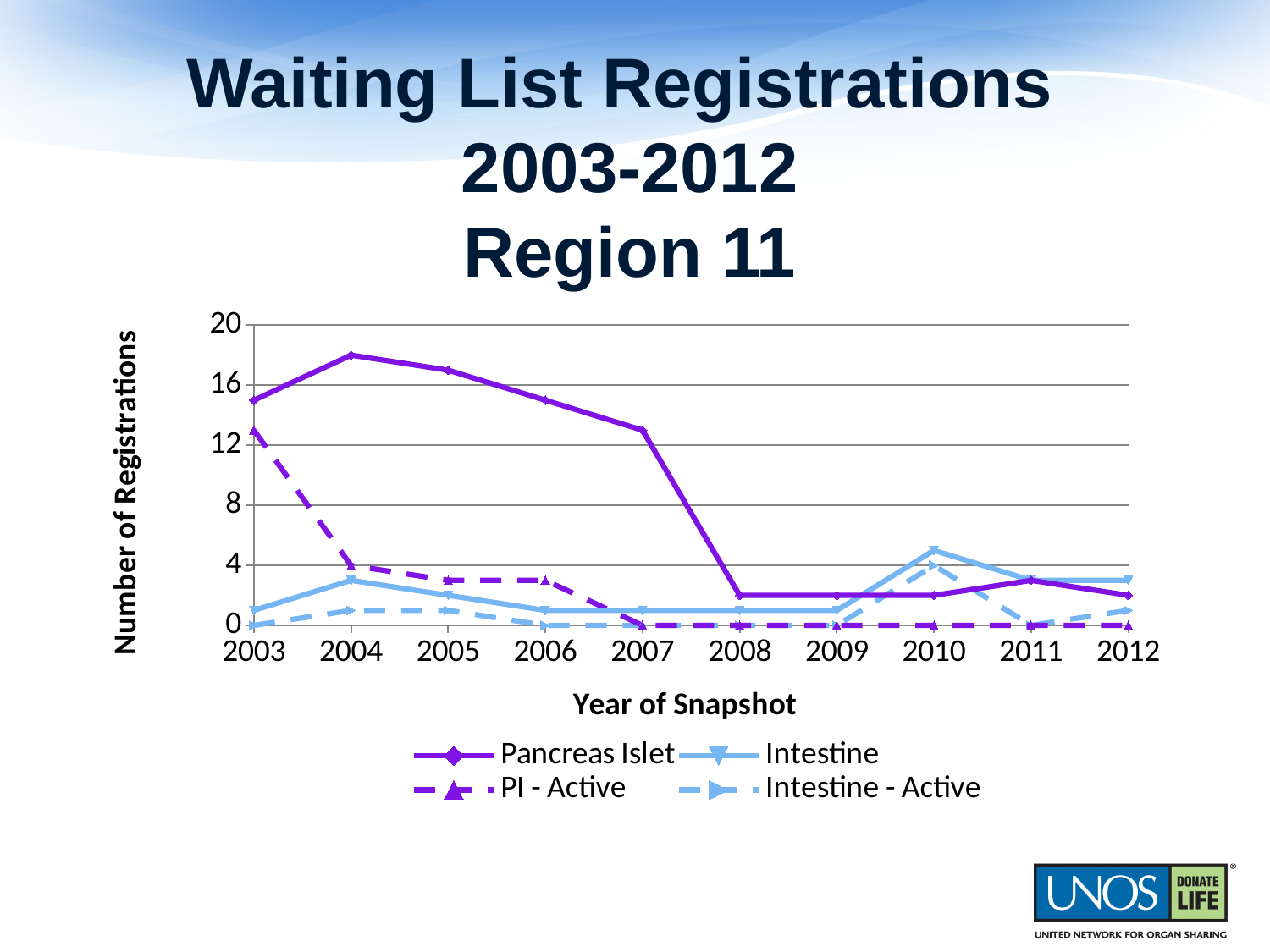
What is the label of the y axis? Number of Registrations How many series does the legend list? 4 What kind of chart is shown on the slide? line chart What is the label of the x axis? Year of Snapshot Is the PI - Active value for 2003 greater or less than 12? greater Is the Pancreas Islet value for 2004 greater or less than 16? greater How many years are plotted along the x axis? 10 Does the Pancreas Islet series generally rise or fall from 2004 to 2008? fall Which series has the larger value in 2003, Pancreas Islet or Intestine? Pancreas Islet In which year does the Pancreas Islet series reach its highest value? 2004 Is the Pancreas Islet value for 2008 greater or less than 4? less What is the PI - Active value for 2012? 0